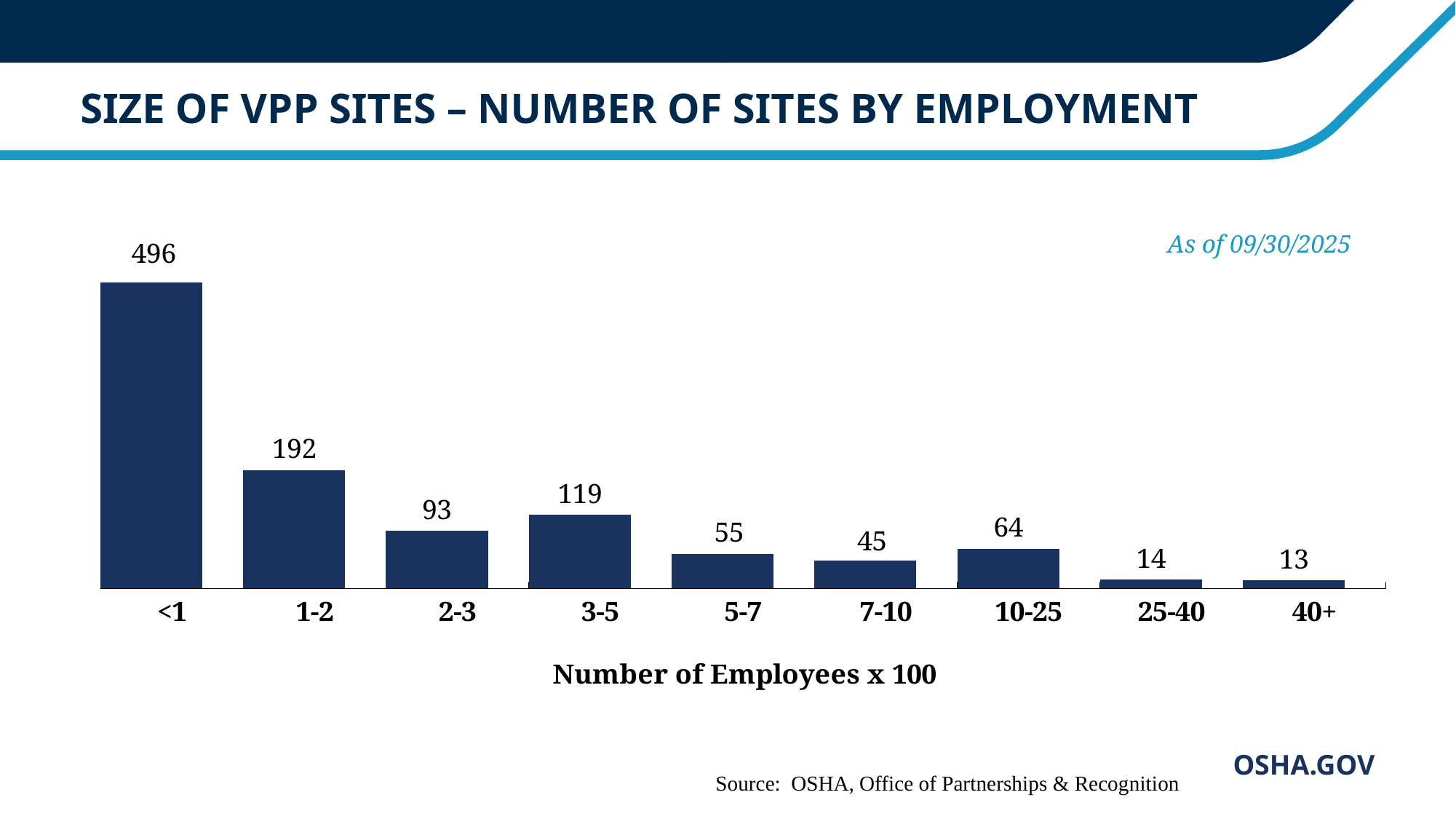
What type of chart is shown on the slide? Bar chart Which employee-size category has the lowest number of sites? 40+ What is the number of sites in the "3-5" employee category? 119 Which employee-size category has the highest number of sites? <1 What is the number of sites in the "10-25" employee category? 64 How many employee-size categories are shown on the chart? 9 What is the difference between the number of sites in the "3-5" category and the "2-3" category? 26 How many VPP sites have fewer than 100 employees (the "<1" category)? 496 What is the x-axis label of the chart? Number of Employees x 100 Which category has more sites, "2-3" or "3-5"? 3-5 What is the difference between the number of sites in the "<1" category and the "1-2" category? 304 Which category has more sites, "5-7" or "7-10"? 5-7